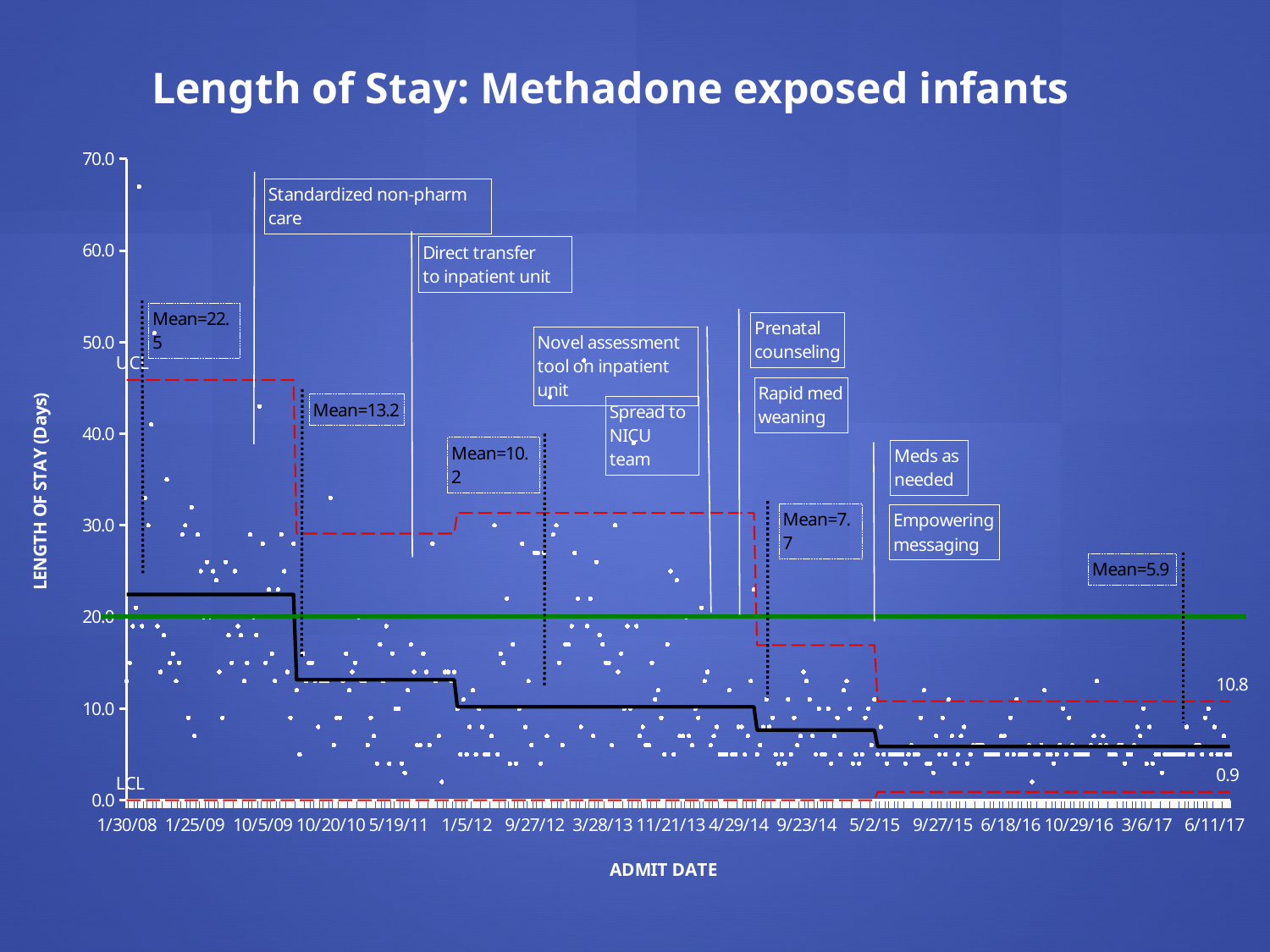
Which period has the lowest mean length of stay? The final period (Mean=5.9) What is the mean length of stay shown for the first period of the chart? 22.5 What is the difference between the first period mean (22.5) and the final period mean (5.9)? 16.6 What is the value printed at the right end of the lower control limit line? 0.9 What is the mean length of stay shown for the period labelled Mean=7.7? 7.7 Which period has the highest mean length of stay? The first period (Mean=22.5) What is the title of the chart? Length of Stay: Methadone exposed infants What is the label of the y axis? LENGTH OF STAY (Days) What is the mean length of stay shown for the final period of the chart? 5.9 What is the mean length of stay shown for the second period, after the first step down? 13.2 Does the mean length of stay rise or fall over time along the x axis? Fall What is the value printed at the right end of the upper control limit line? 10.8